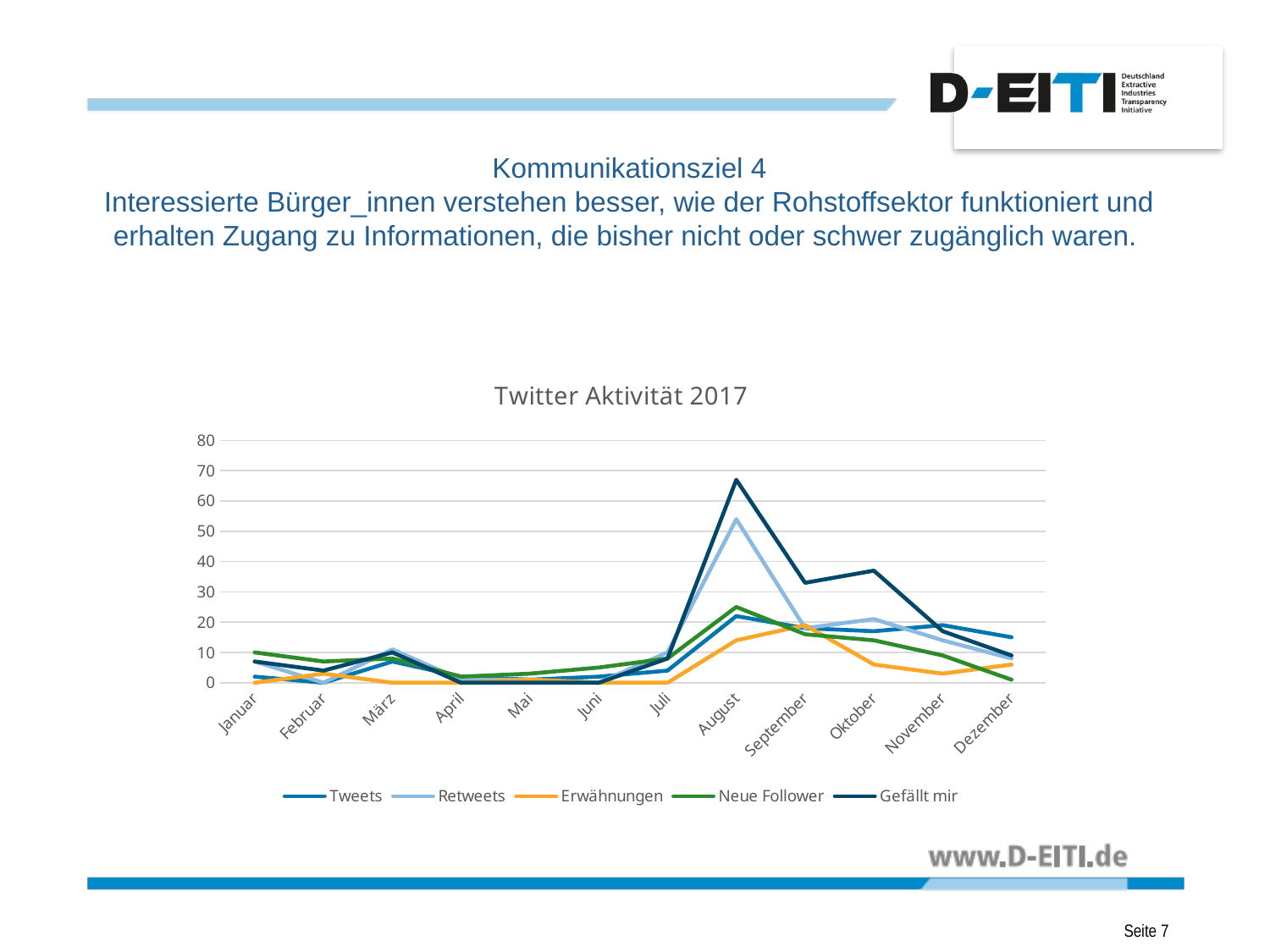
Is the value for Retweets in August greater or less than 50? greater How many series does the legend list? 5 Does the Gefällt mir series rise or fall from August to September? fall What kind of chart is shown on the slide? line chart In which month does the Gefällt mir series reach its highest value? August Which series has the highest value in August? Gefällt mir Is the value for Gefällt mir in Oktober greater or less than 30? greater Is the value for Gefällt mir in August greater or less than 60? greater How many months are shown on the x axis? 12 What is the title of the chart? Twitter Aktivität 2017 Which is larger in Oktober, Gefällt mir or Tweets? Gefällt mir